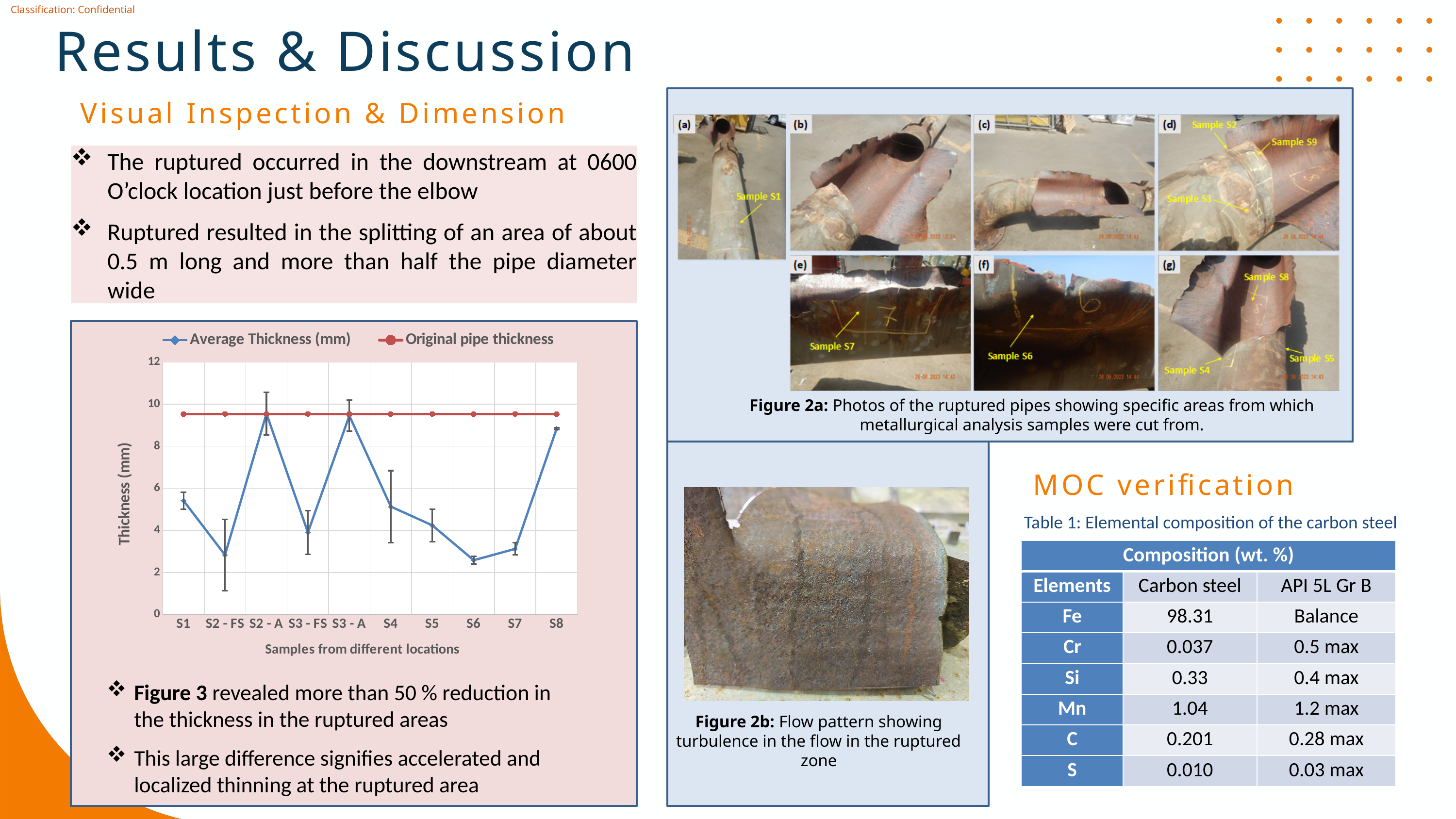
In the thickness chart, is the Average Thickness for S8 greater or less than 8 mm? greater In the thickness chart, which has the larger Average Thickness, S1 or S6? S1 In the thickness chart, is the Average Thickness for S2 - FS greater or less than 4 mm? less In the thickness chart, is the Original pipe thickness greater or less than 8 mm? greater How many series does the legend of the thickness chart list? 2 What is the y-axis label of the thickness chart? Thickness (mm) How many sample locations are plotted along the x axis of the thickness chart? 10 What kind of chart is shown in the Visual Inspection & Dimension section? line chart In the thickness chart, which has the larger Average Thickness, S8 or S4? S8 In the thickness chart, does the Average Thickness rise or fall from S4 to S6? fall